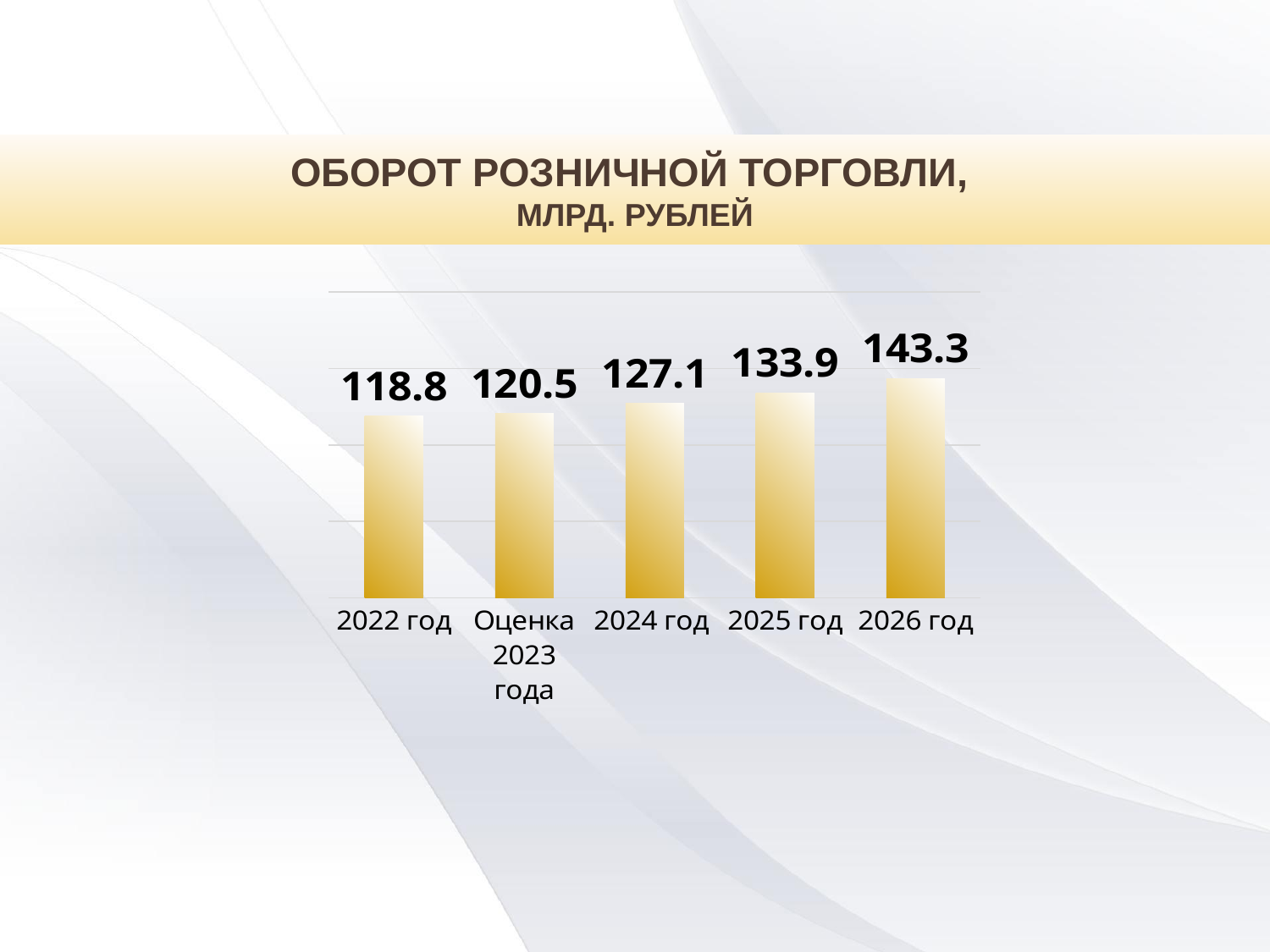
What is the value shown for 2026 год? 143.3 Do the values rise or fall from left to right along the x axis? rise How many categories are shown on the x axis? 5 What kind of chart is shown on the slide? bar chart What is the retail trade turnover value for 2022 год? 118.8 Which is larger, the value for 2025 год or the value for 2024 год? 2025 год What is the difference between the values for 2026 год and 2022 год? 24.5 What is the value shown for Оценка 2023 года? 120.5 What is the difference between the values for 2025 год and 2024 год? 6.8 What is the value shown for 2024 год? 127.1 Which category has the highest value? 2026 год Which category has the lowest value? 2022 год